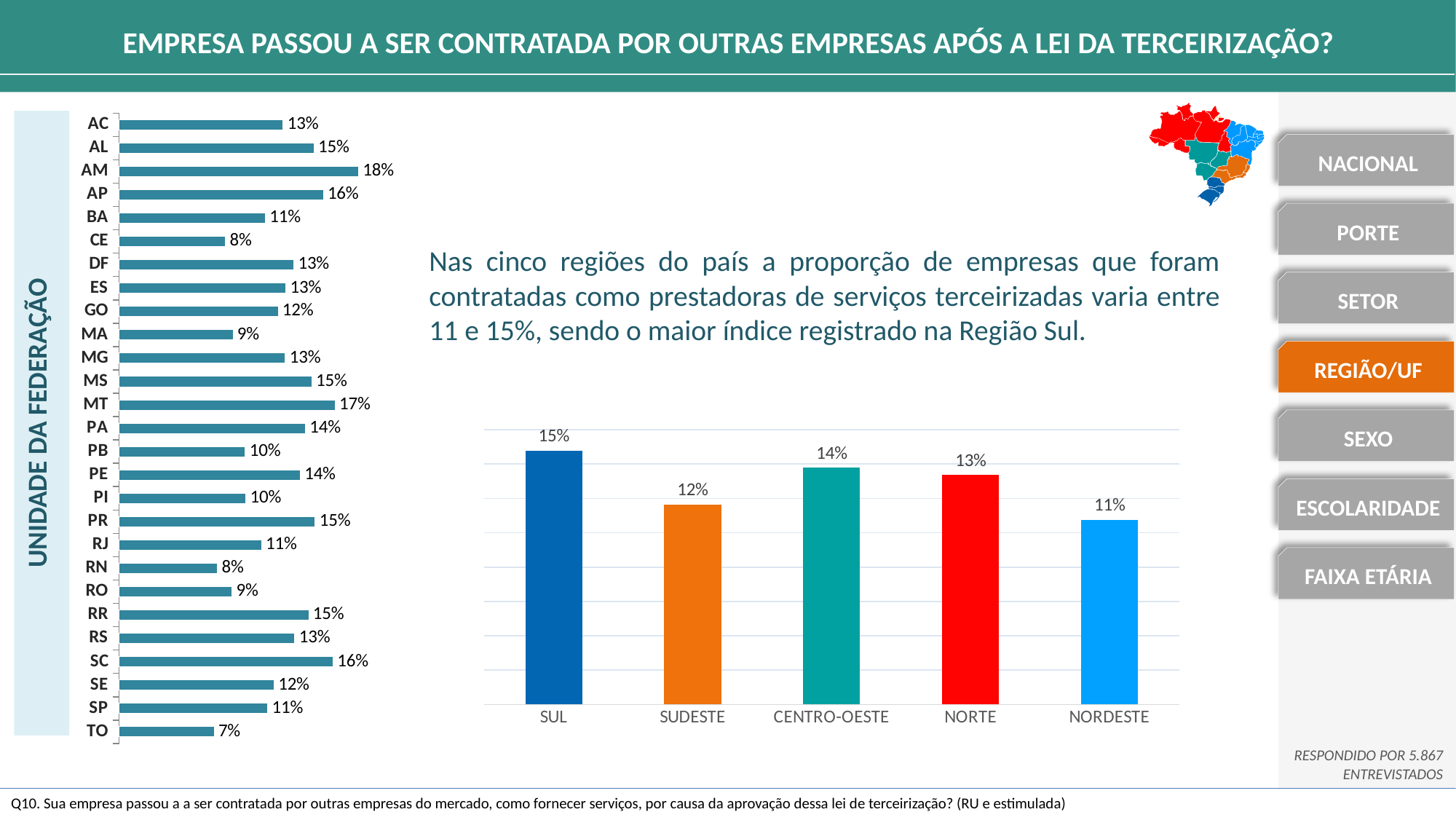
In the left chart (Unidade da Federação), which state has the highest value? AM In the left chart (Unidade da Federação), which state has the lowest value? TO In the left chart (Unidade da Federação), what is the value for AM? 18% In the left chart (Unidade da Federação), which is larger, the value for PA or the value for PB? PA In the right chart of regions, what is the difference between the values for SUL and SUDESTE? 3% In the right chart of regions, which region has the lowest value? NORDESTE In the right chart of regions, which region has the highest value? SUL In the left chart (Unidade da Federação), what is the difference between the values for MT and CE? 9% What kind of chart is the right chart of regions? Bar chart In the right chart of regions, what is the value for CENTRO-OESTE? 14% How many states are shown in the left chart (Unidade da Federação)? 27 In the left chart (Unidade da Federação), what is the value for SC? 16%